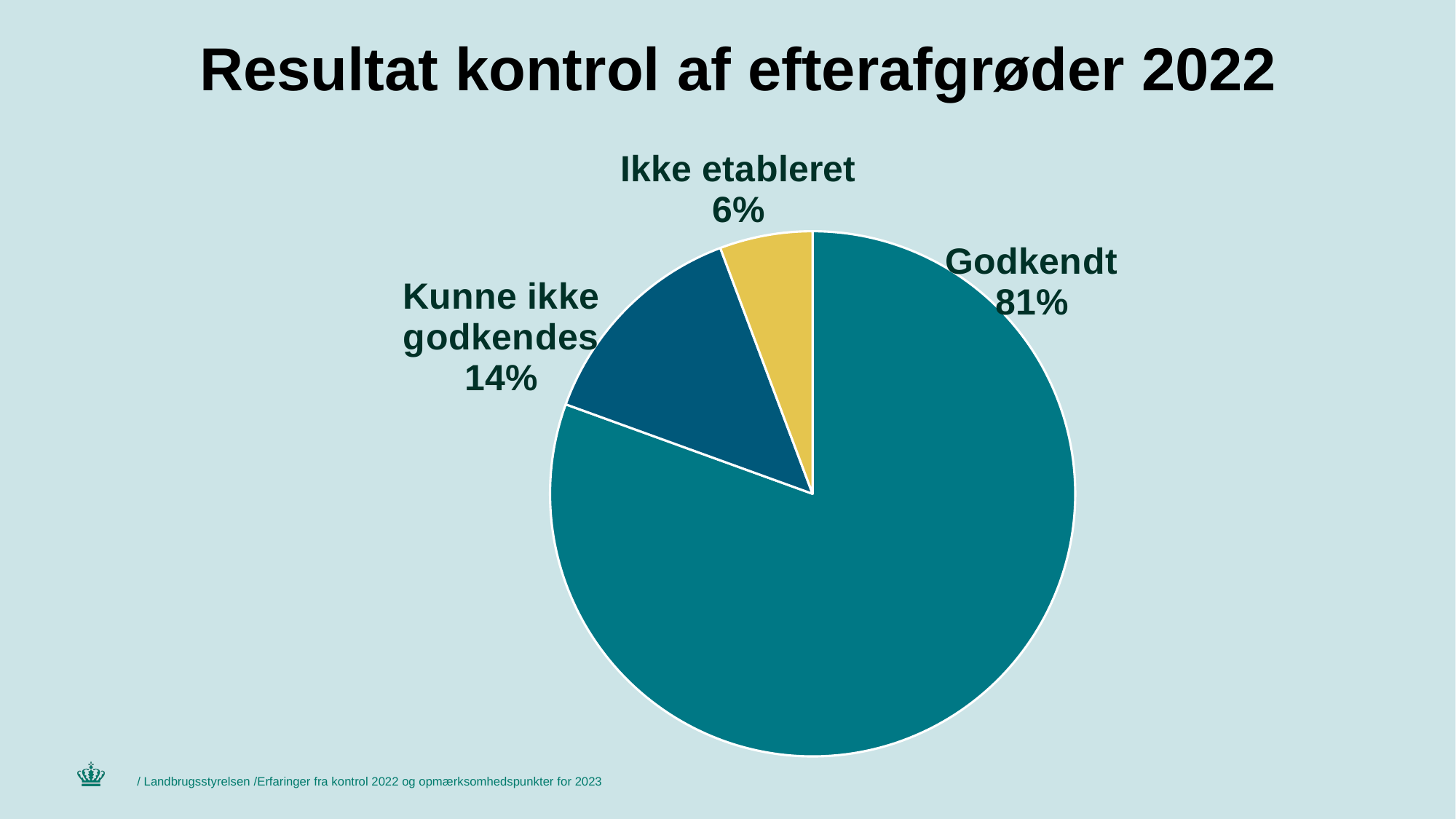
What is the title of the slide? Resultat kontrol af efterafgrøder 2022 What kind of chart is shown on the slide? Pie chart Which is larger, the share for Kunne ikke godkendes or the share for Ikke etableret? Kunne ikke godkendes What share of the pie does Godkendt represent? 81% What colour is the slice for Ikke etableret? Yellow What share of the pie does Ikke etableret represent? 6% What share of the pie does Kunne ikke godkendes represent? 14% Which category has the smallest slice of the pie? Ikke etableret Which category has the largest slice of the pie? Godkendt How many categories are shown in the pie chart? 3 What is the difference in percentage points between Godkendt and Kunne ikke godkendes? 67 What is the difference in percentage points between Kunne ikke godkendes and Ikke etableret? 8